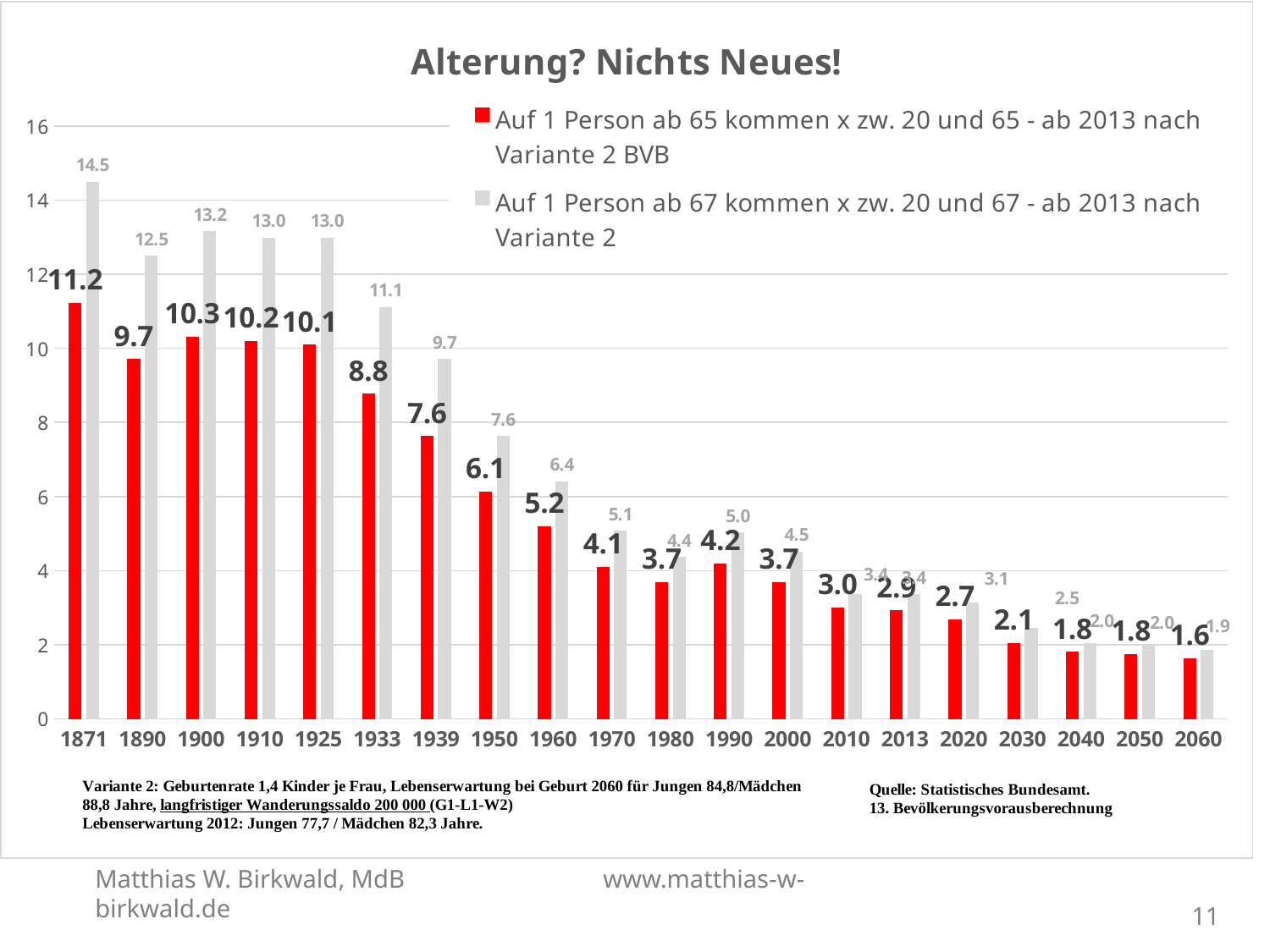
Which year has the highest value in the grey series (ab 67)? 1871 Is the red series (ab 65) value for 1933 greater or less than 8? greater How many years are shown on the x axis? 20 What is the difference between the grey (ab 67) and red (ab 65) values for 1871? 3.3 What is the value of the grey series (ab 67) for 1900? 13.2 What is the title of the chart? Alterung? Nichts Neues! What is the value of the red series (ab 65) for 1871? 11.2 What kind of chart is shown on the slide? bar chart How many series does the legend list? 2 Which is larger for 1990: the red series (ab 65) or the grey series (ab 67)? the grey series (ab 67) Which year has the lowest value in the red series (ab 65)? 2060 What is the value of the red series (ab 65) for 2060? 1.6